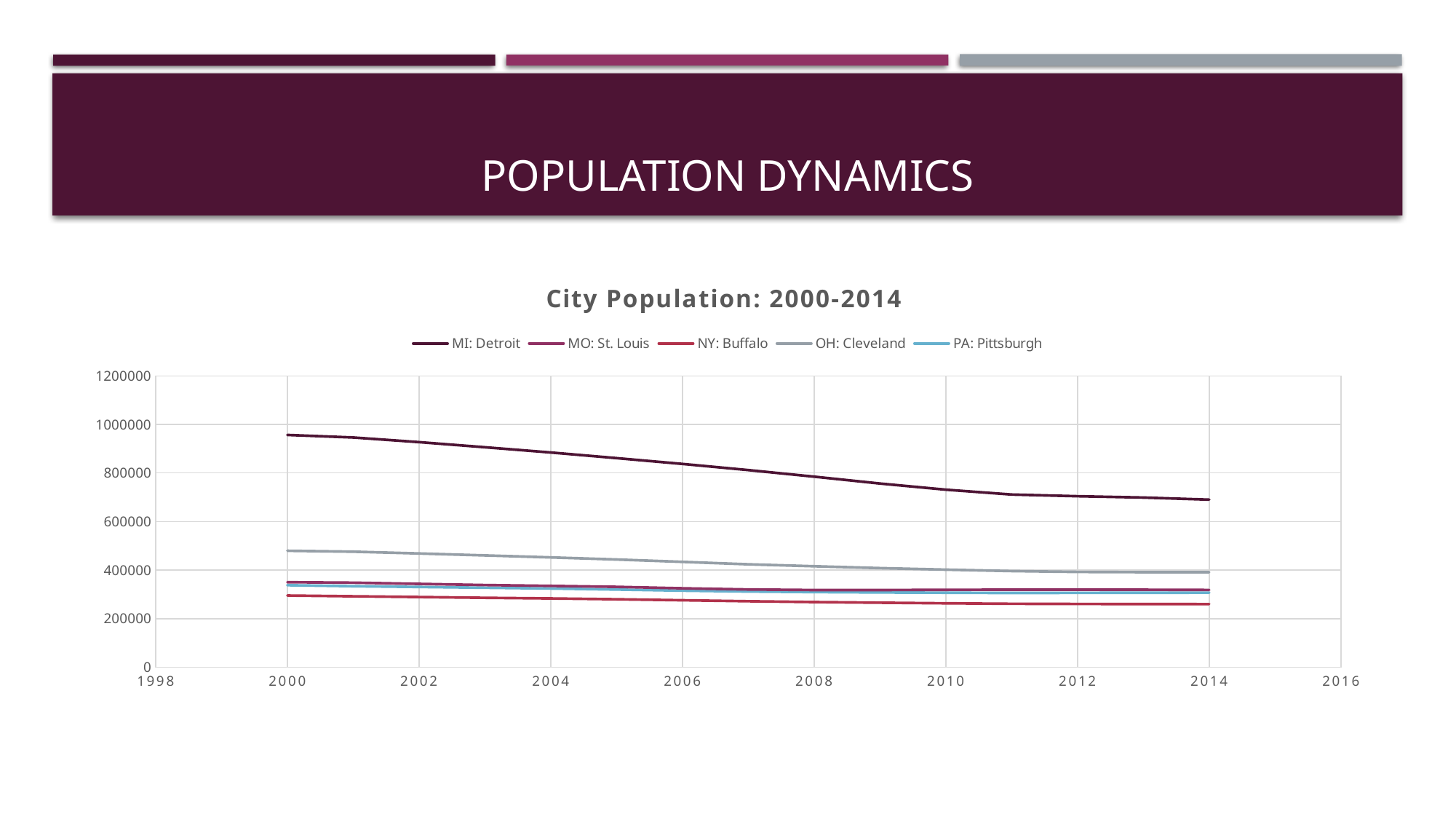
Which city has the larger population in 2010, OH: Cleveland or NY: Buffalo? OH: Cleveland Which city has the highest population throughout the chart? MI: Detroit Is the population of OH: Cleveland in 2000 greater or less than 400000? greater Is the population of MI: Detroit in 2014 greater or less than 800000? less How many series does the legend list in the City Population chart? 5 What is the title of the chart? City Population: 2000-2014 Is the population of NY: Buffalo in 2014 greater or less than 200000? greater Does the population of MI: Detroit rise or fall from 2000 to 2014? fall Does the population of OH: Cleveland rise or fall from 2000 to 2014? fall What kind of chart is shown on the slide? line chart Which city has the lowest population throughout the chart? NY: Buffalo